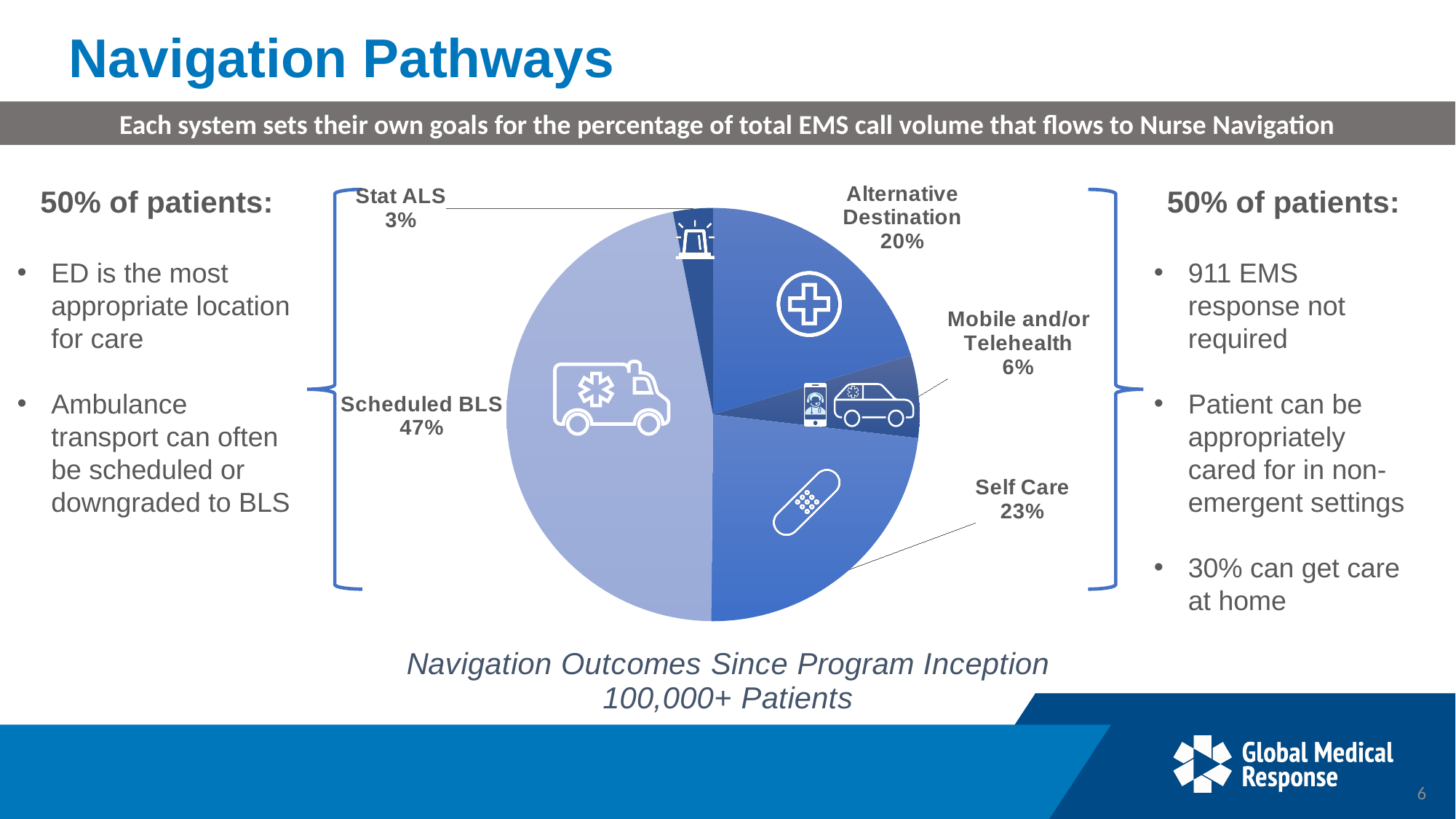
What percentage of the pie chart is Self Care? 23% What kind of chart is shown on the slide? Pie chart Which is larger, Self Care or Alternative Destination? Self Care What is the caption below the pie chart? Navigation Outcomes Since Program Inception 100,000+ Patients Which slice of the pie chart is the smallest? Stat ALS Which slice of the pie chart is the largest? Scheduled BLS What percentage of the pie chart is Mobile and/or Telehealth? 6% What percentage of the pie chart is Stat ALS? 3% What percentage of the pie chart is Scheduled BLS? 47% What percentage of the pie chart is Alternative Destination? 20% How many slices does the pie chart have? 5 What is the difference in percentage points between Scheduled BLS and Self Care? 24